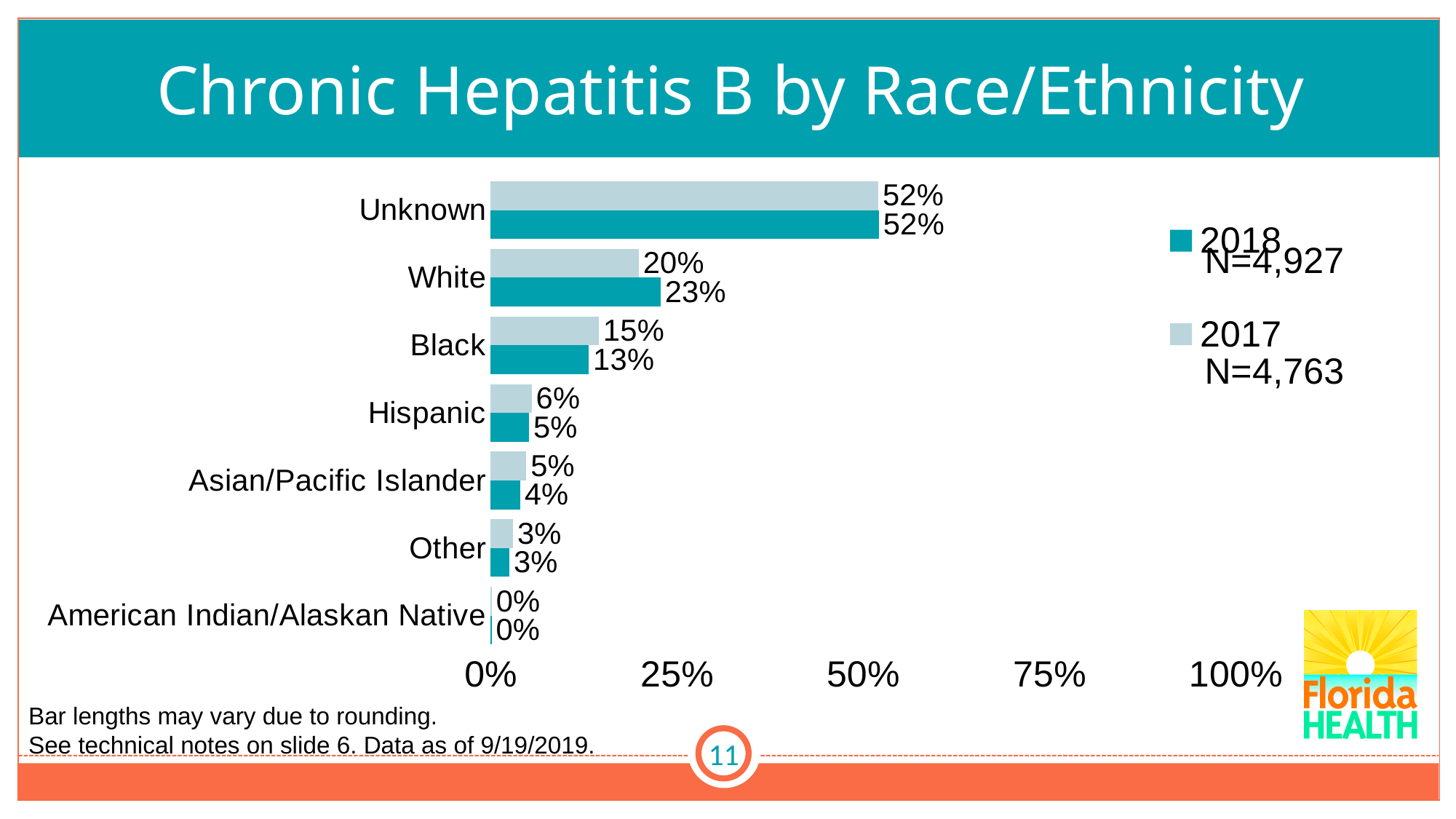
How many series does the legend list? 2 Which race/ethnicity category has the highest percentage in 2018? Unknown What is the difference between the 2018 and 2017 values for White? 3% What percentage of chronic hepatitis B cases were White in 2018? 23% Which is larger for Black: the 2017 value or the 2018 value? 2017 What is the 2018 value for Hispanic? 5% Which race/ethnicity category has the lowest percentage in 2017? American Indian/Alaskan Native What kind of chart is shown on the slide? Bar chart What percentage of chronic hepatitis B cases were Black in 2017? 15% How many race/ethnicity categories are shown on the chart? 7 Is the 2018 value for Unknown greater or less than 50%? greater What is the N for 2018 shown in the legend? N=4,927